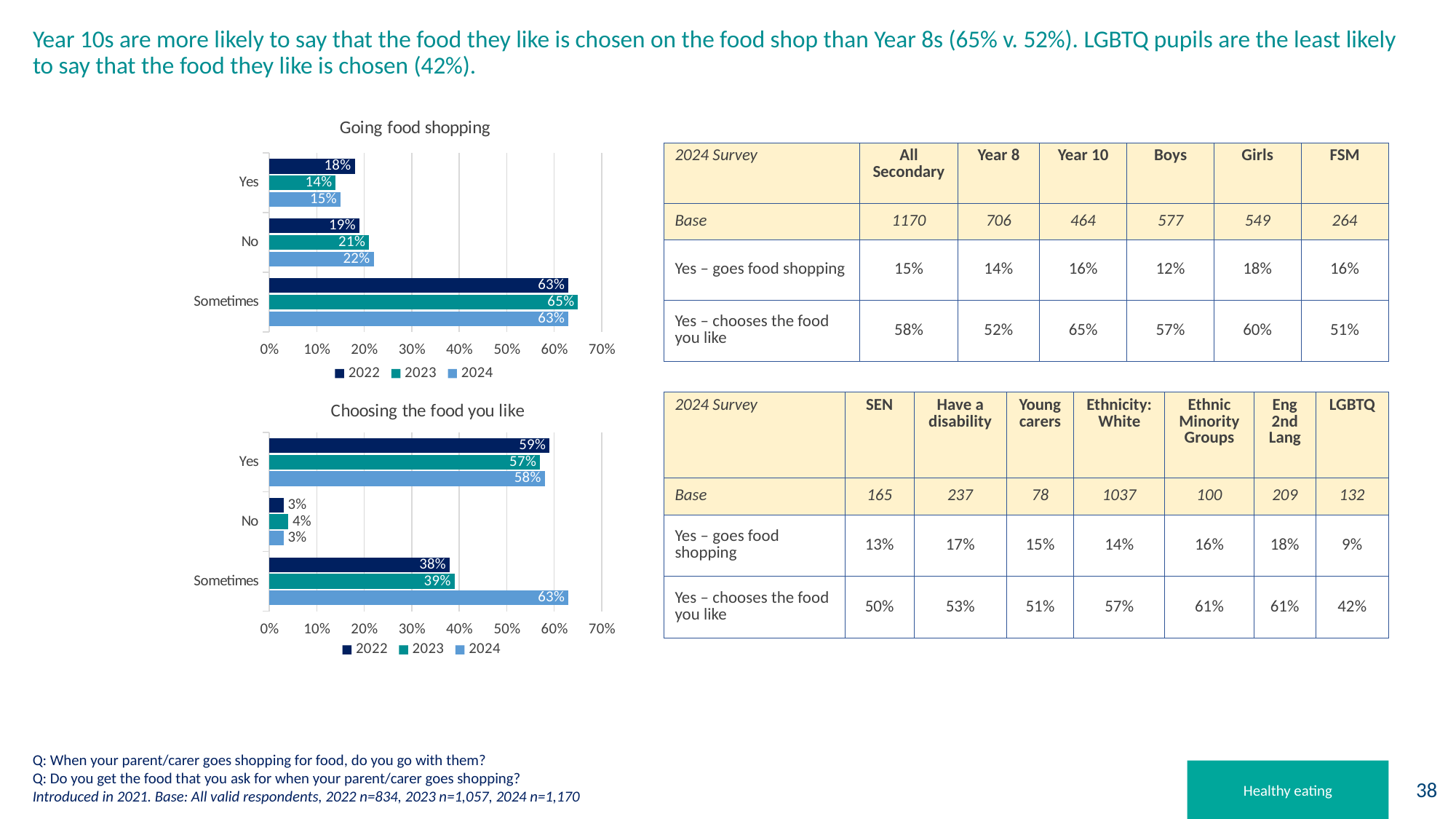
In the 'Going food shopping' chart, what is the value for 'Yes' in 2022? 18% What kind of chart is the 'Going food shopping' chart? Bar chart In the 'Going food shopping' chart, which category has the highest value in 2022? Sometimes How many series does the legend of the 'Going food shopping' chart list? 3 In the 'Choosing the food you like' chart, what is the difference between the 2024 and 2023 values for 'Sometimes'? 24% In the 'Choosing the food you like' chart, which category has the lowest value in 2024? No In the 'Going food shopping' chart, what is the value for 'Sometimes' in 2023? 65% In the 'Choosing the food you like' chart, what is the difference between the 2022 and 2023 values for 'Yes'? 2% How many categories are shown on the 'Choosing the food you like' chart? 3 In the 'Choosing the food you like' chart, what is the value for 'No' in 2023? 4% In the 'Going food shopping' chart, which is larger: the 2024 value for 'No' or the 2024 value for 'Yes'? No In the 'Choosing the food you like' chart, what is the value for 'Sometimes' in 2024? 63%